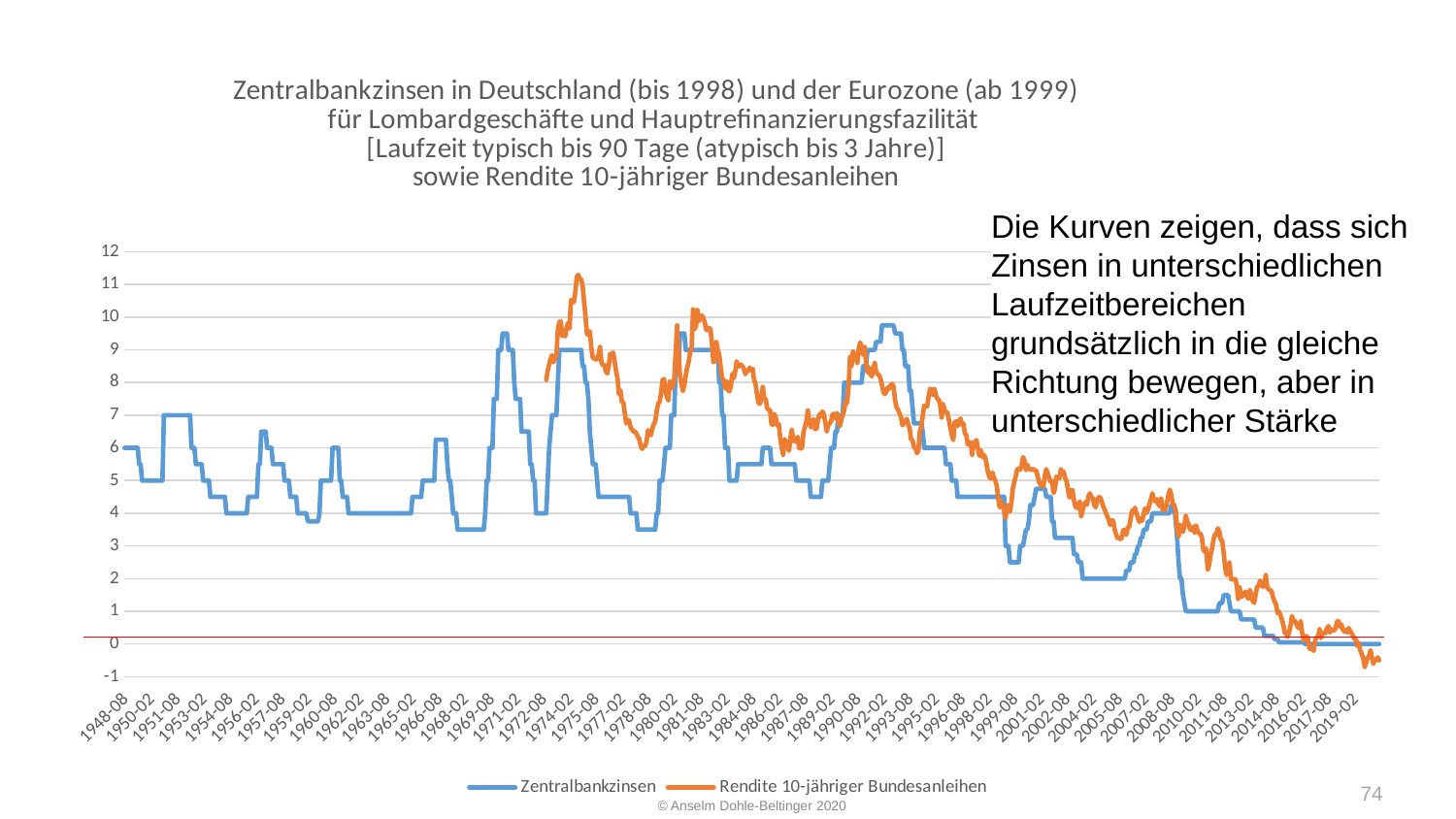
Which series reaches the higher peak value over the whole period? Rendite 10-jähriger Bundesanleihen Is the peak value of Zentralbankzinsen around 1992-1993 greater or less than 9? greater Which series is drawn in orange? Rendite 10-jähriger Bundesanleihen How many series does the legend list? 2 Is the value of Zentralbankzinsen around 2016-02 greater or less than 1? less What kind of chart is shown on the slide? line chart Do the values of both series generally rise or fall from the early 1990s to 2019? fall Is the value of Zentralbankzinsen at 1948-08 greater or less than 5? greater Around 1974-02, which series has the higher value, Zentralbankzinsen or Rendite 10-jähriger Bundesanleihen? Rendite 10-jähriger Bundesanleihen Which series is drawn in blue? Zentralbankzinsen